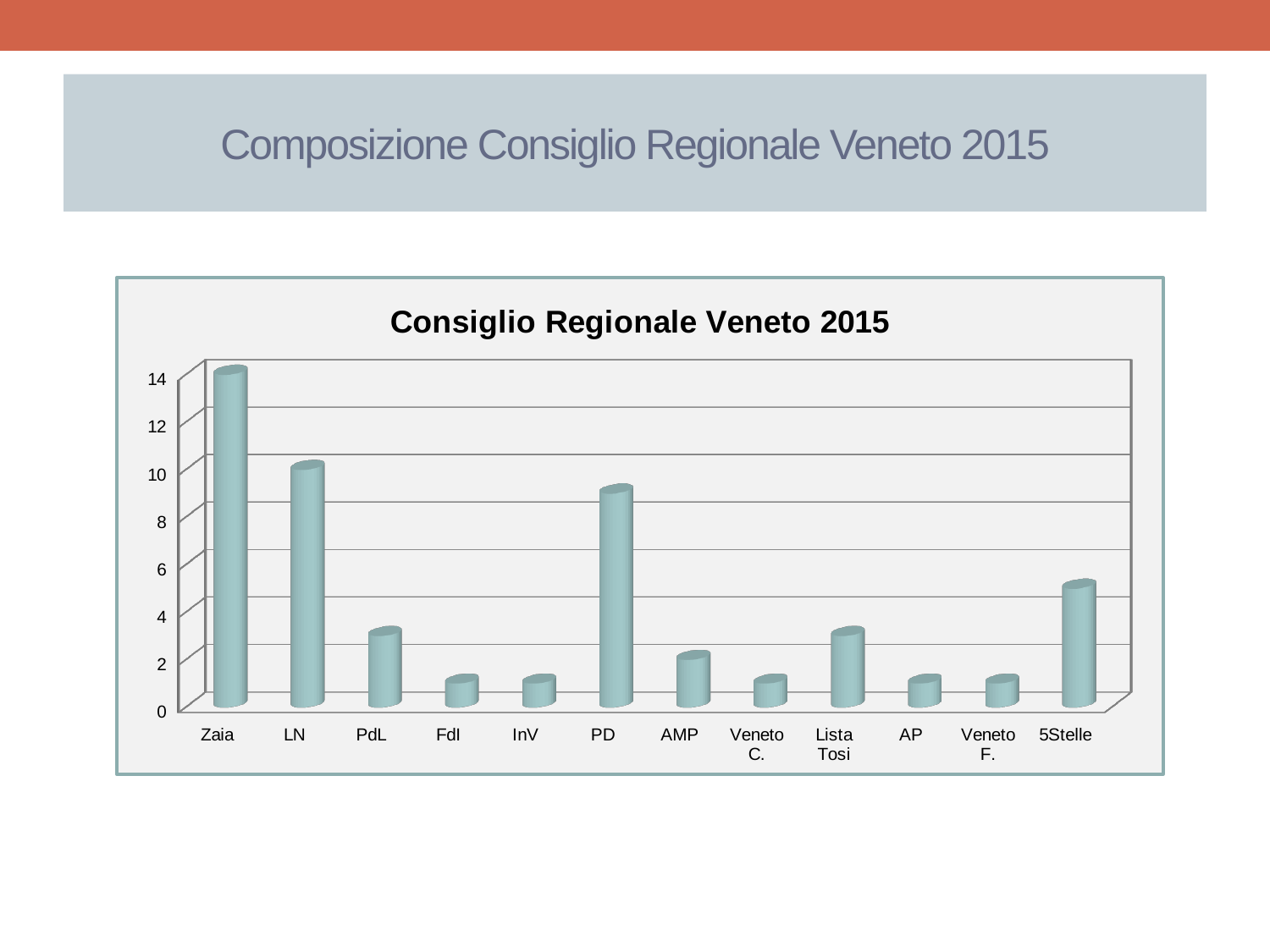
Is the value for AMP greater or less than 4? less Which is larger, the value for PD or the value for 5Stelle? PD What kind of chart is shown on the slide? bar chart Which is larger, the value for Zaia or the value for LN? Zaia Is the value for LN greater or less than 8? greater Is the value for PD greater or less than 10? less Which is larger, the value for PdL or the value for FdI? PdL How many categories are shown on the x axis of the chart? 12 Which category has the highest value in the chart? Zaia What is the title of the chart? Consiglio Regionale Veneto 2015